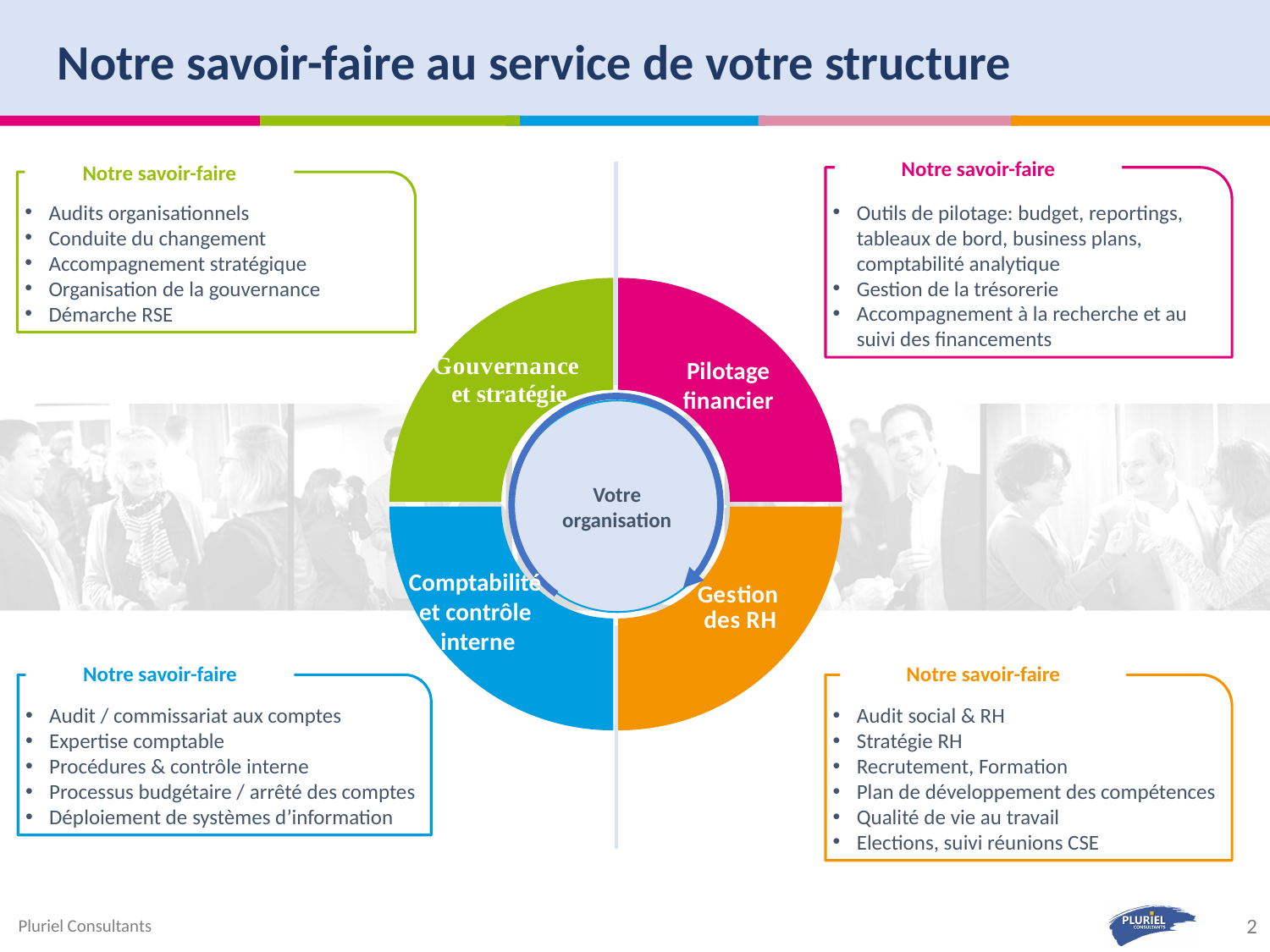
Which segment of the circular diagram is coloured pink? Pilotage financier Which segment of the circular diagram is in the top-left quadrant? Gouvernance et stratégie How many segments does the circular diagram in the centre of the slide have? 4 Which segment of the circular diagram is coloured blue? Comptabilité et contrôle interne Are the four segments of the circular diagram equal in size? Yes What text appears in the centre of the circular diagram? Votre organisation Which segment of the circular diagram is in the bottom-right quadrant? Gestion des RH